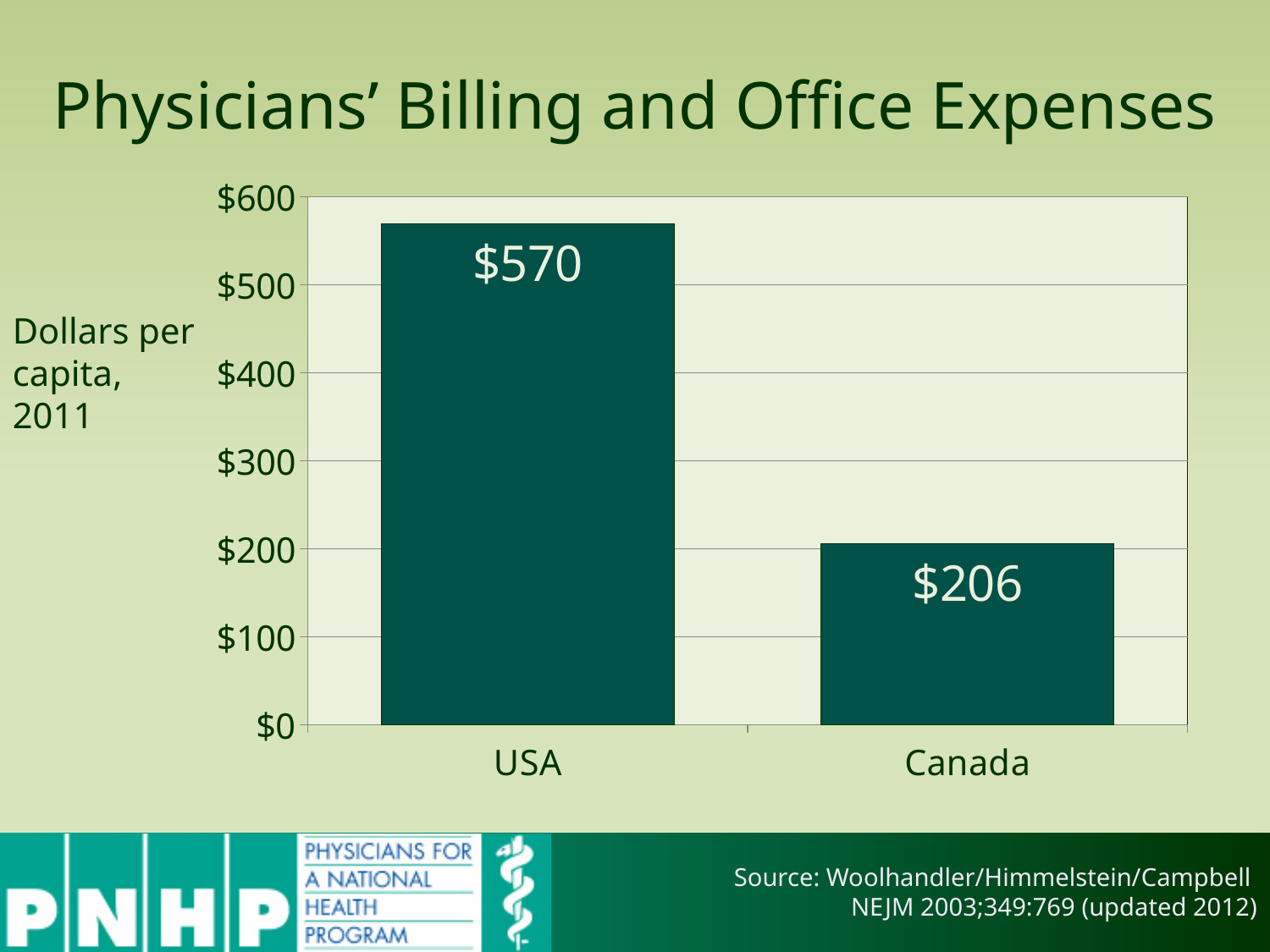
Is the value for Canada greater or less than $300? less How many categories are shown on the chart? 2 What kind of chart is shown on the slide? bar chart What is the title of the chart? Physicians' Billing and Office Expenses Which category has the lowest value? Canada Which is larger, the value for USA or the value for Canada? USA What is the difference between the values for USA and Canada? $364 Which category has the highest value? USA What is the value for USA? $570 What unit is the vertical axis measured in, according to the label on the left? Dollars per capita, 2011 Is the value for USA greater or less than $500? greater What is the value for Canada? $206